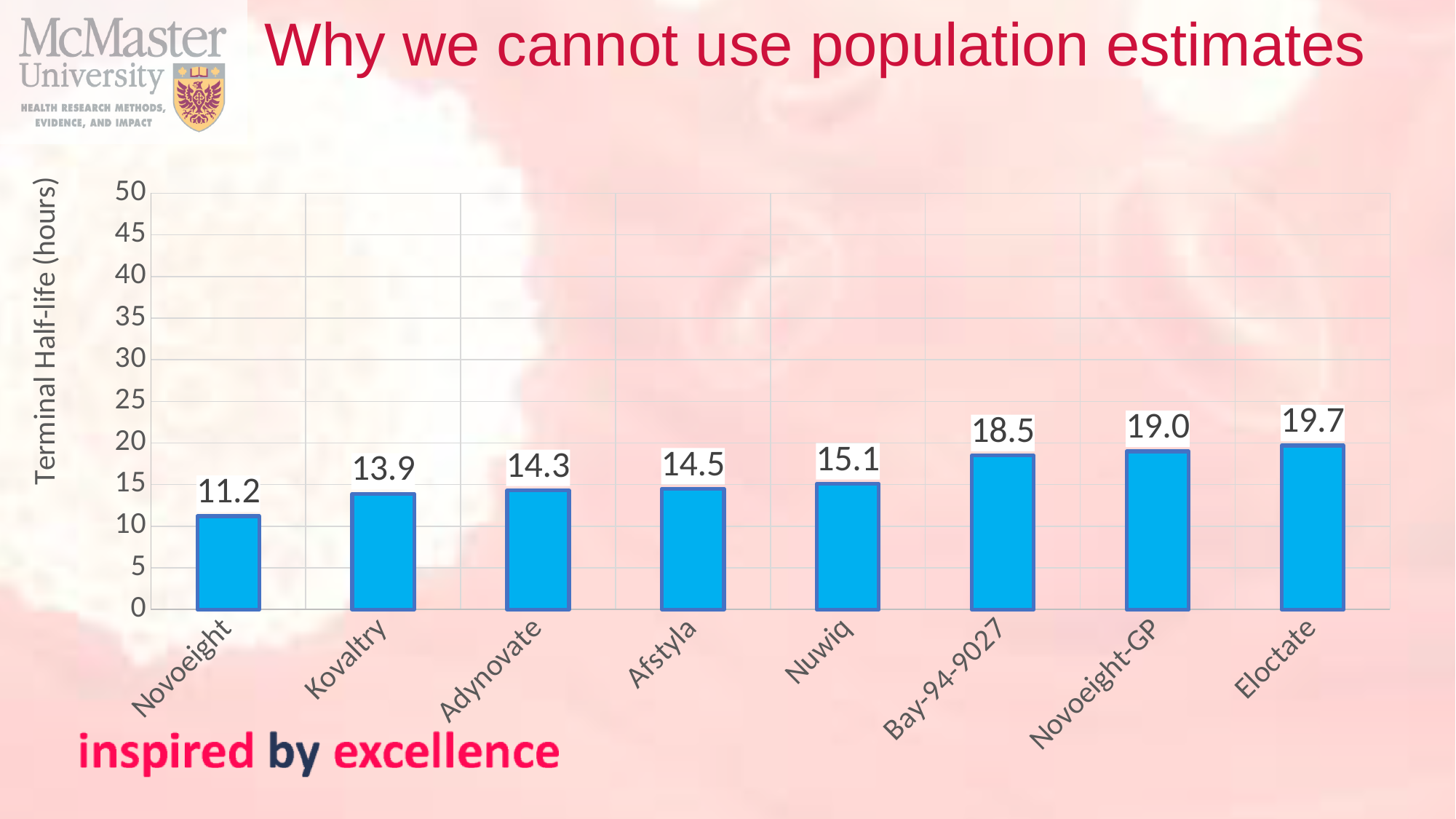
What is the difference in terminal half-life between Eloctate and Novoeight? 8.5 Which has a longer terminal half-life, Adynovate or Bay-94-9027? Bay-94-9027 What is the terminal half-life for Bay-94-9027? 18.5 How many products are shown on the chart? 8 What is the terminal half-life for Novoeight? 11.2 What is the difference in terminal half-life between Novoeight-GP and Kovaltry? 5.1 What is the label of the vertical axis? Terminal Half-life (hours) Is the value for Afstyla greater or less than 20? less What kind of chart is shown on the slide? bar chart Which product has the lowest terminal half-life? Novoeight What is the terminal half-life for Nuwiq? 15.1 Which product has the highest terminal half-life? Eloctate